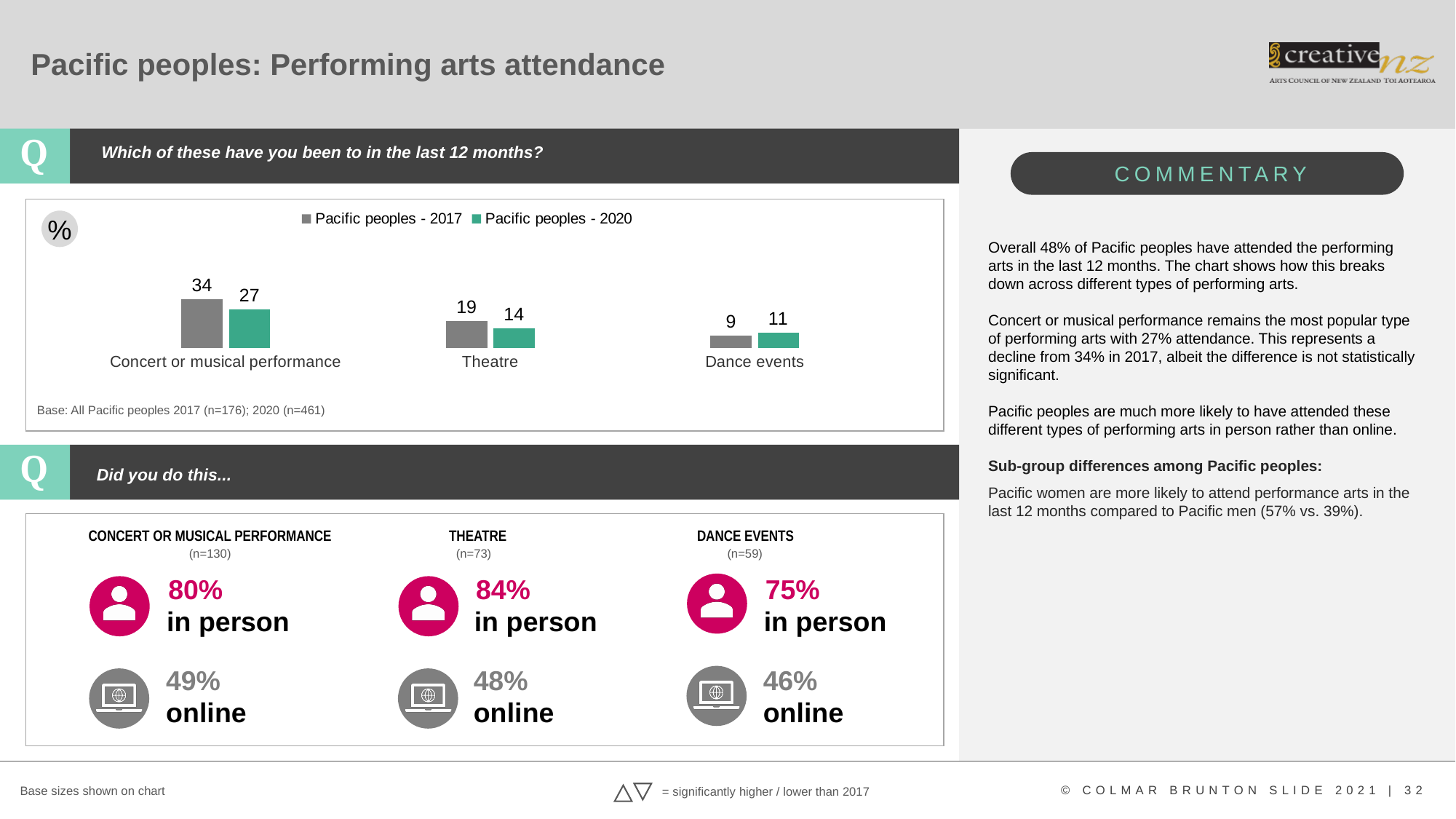
What is the difference between the 2017 and 2020 values for Theatre? 5 What is the value for Concert or musical performance in the Pacific peoples - 2020 series? 27 What is the value for Theatre in the Pacific peoples - 2017 series? 19 What colour are the bars for the Pacific peoples - 2020 series? Green How many series does the chart legend list? 2 What is the difference between the 2017 and 2020 values for Concert or musical performance? 7 For Dance events, which series has the larger value, Pacific peoples - 2017 or Pacific peoples - 2020? Pacific peoples - 2020 Which category has the highest value in the Pacific peoples - 2017 series? Concert or musical performance What is the value for Dance events in the Pacific peoples - 2020 series? 11 Which category has the lowest value in the Pacific peoples - 2020 series? Dance events What kind of chart is shown under the question 'Which of these have you been to in the last 12 months?'? Bar chart How many categories are shown on the bar chart? 3